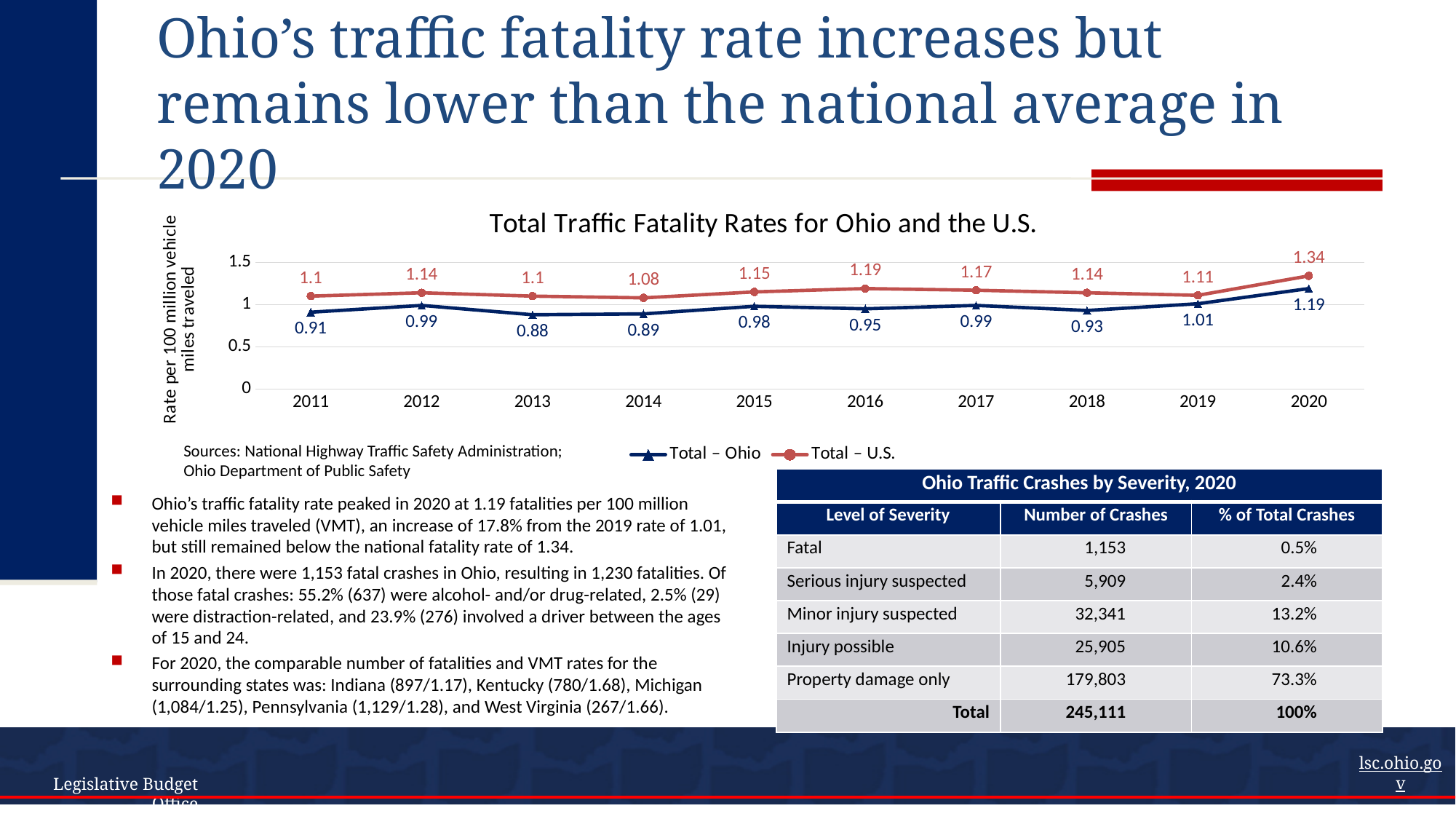
How many series does the chart's legend list? 2 Is the Total – Ohio value for 2018 greater or less than 1? less What is the Total – Ohio value for 2013? 0.88 How many years are shown on the x axis of the chart? 10 In which year is the Total – U.S. rate highest? 2020 What is the Total – U.S. value for 2014? 1.08 What is the Total – Ohio value for 2020? 1.19 Which is larger in 2016, the Total – Ohio value or the Total – U.S. value? Total – U.S. In which year is the Total – Ohio rate lowest? 2013 What is the difference between the Total – U.S. and Total – Ohio values in 2020? 0.15 What kind of chart is shown on the slide? line chart What is the title of the chart? Total Traffic Fatality Rates for Ohio and the U.S.